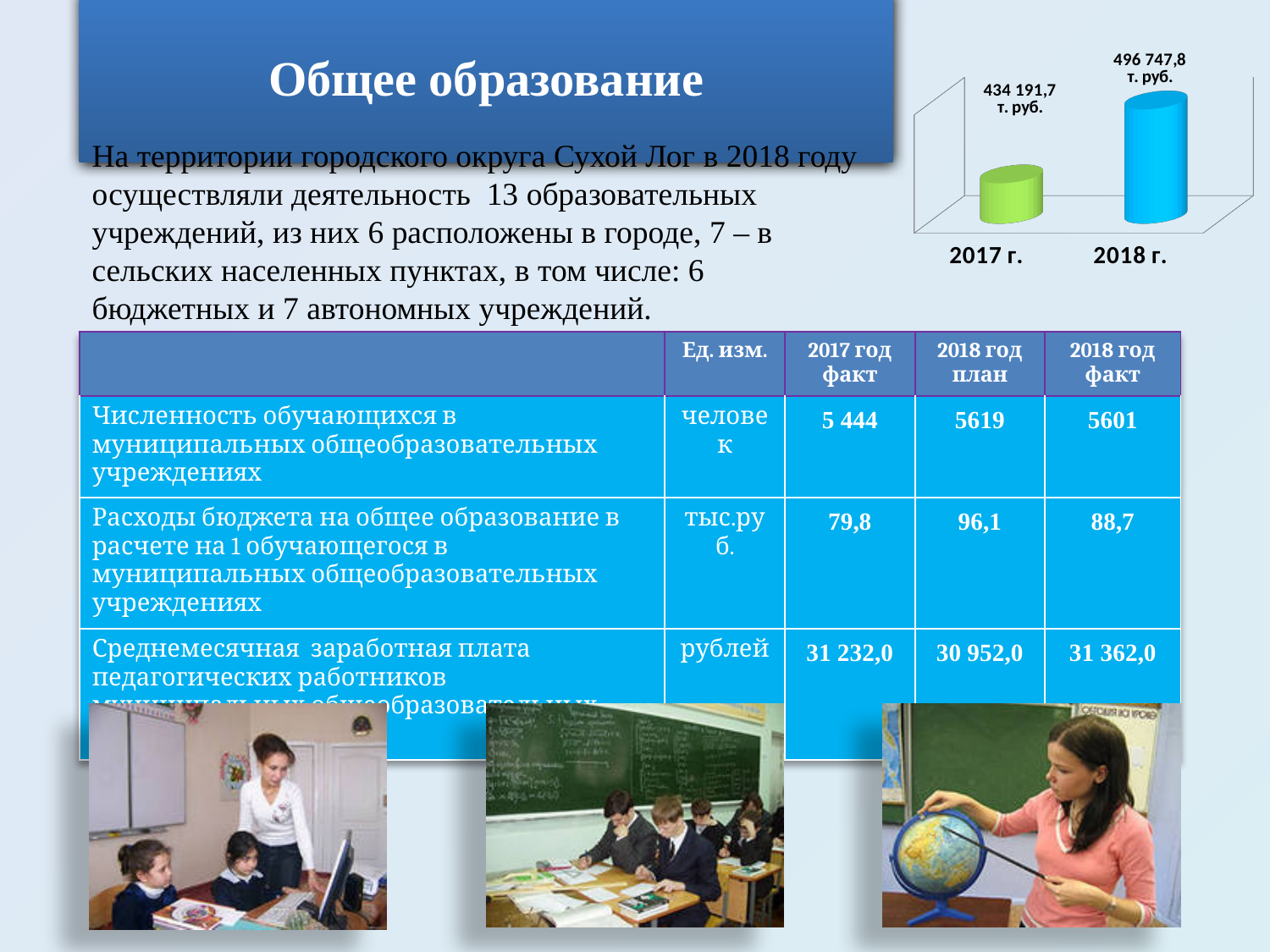
In the bar chart at the top right, is the value for 2017 г. larger or smaller than the value for 2018 г.? smaller In the bar chart at the top right, which year has the higher value? 2018 г. What colour is the 2017 г. bar in the chart at the top right? green What colour is the 2018 г. bar in the chart at the top right? blue How many bars are plotted in the chart at the top right of the slide? 2 What kind of chart is shown at the top right of the slide? bar chart What value is shown for 2017 г. in the bar chart at the top right of the slide? 434 191,7 т. руб. In the bar chart at the top right, by how much does the 2018 г. value exceed the 2017 г. value? 62 556,1 т. руб. What value is shown for 2018 г. in the bar chart at the top right of the slide? 496 747,8 т. руб. In the bar chart at the top right, which year has the lower value? 2017 г. In the bar chart at the top right, does the value rise or fall from 2017 г. to 2018 г.? rise